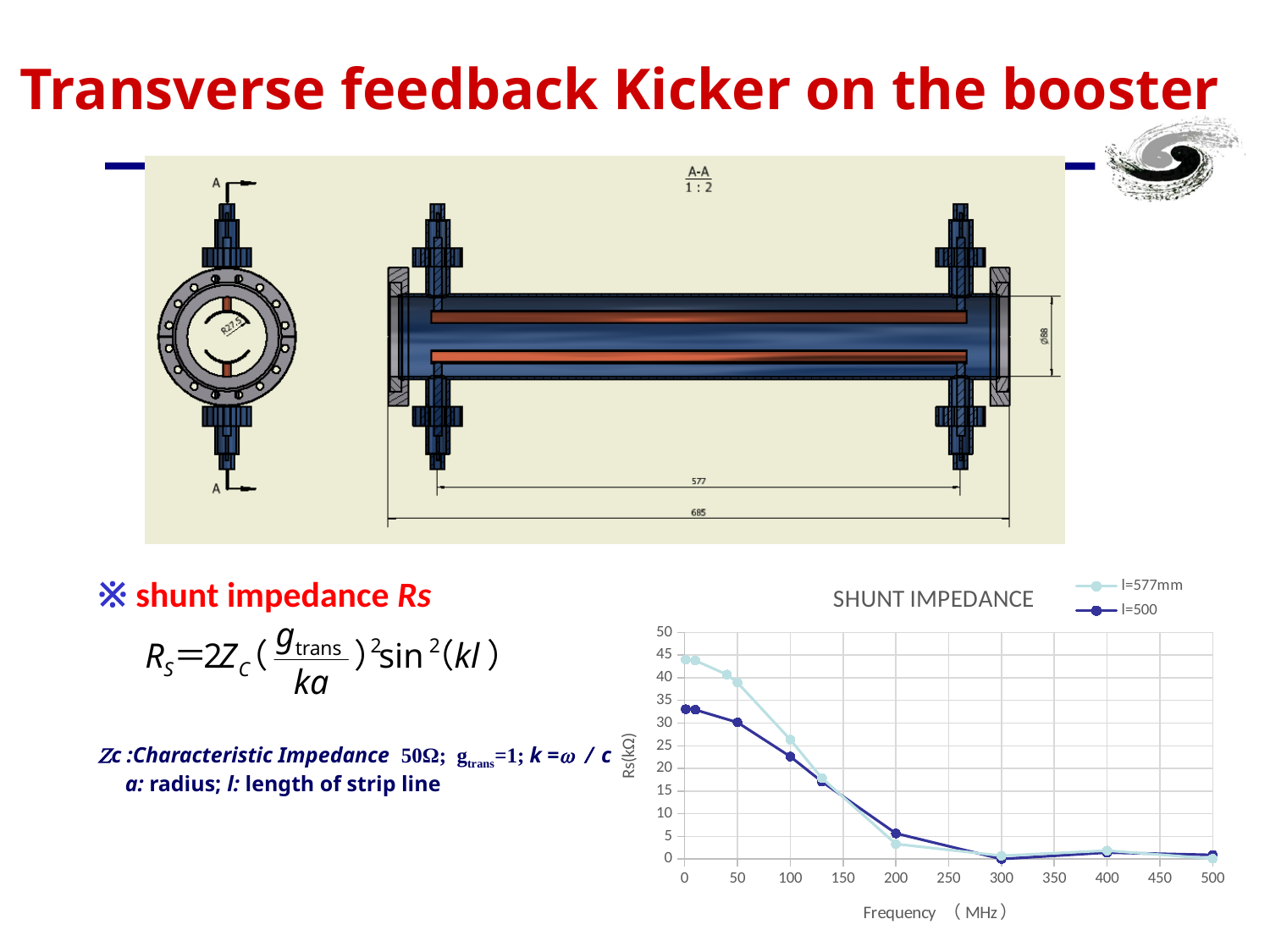
In the SHUNT IMPEDANCE chart, is the value for l=500 at 100 MHz greater or less than 25? less In the SHUNT IMPEDANCE chart, is the value for l=500 at 0 MHz greater or less than 35? less What is the label of the horizontal axis of the SHUNT IMPEDANCE chart? Frequency (MHz) In the SHUNT IMPEDANCE chart, is the value for l=577mm at 200 MHz greater or less than 5? less What kind of chart is the SHUNT IMPEDANCE chart? line chart What is the label of the vertical axis of the SHUNT IMPEDANCE chart? Rs(kΩ) How many series does the legend of the SHUNT IMPEDANCE chart list? 2 In the SHUNT IMPEDANCE chart, which series has the higher value at 0 MHz, l=577mm or l=500? l=577mm In the SHUNT IMPEDANCE chart, do the values rise or fall as frequency increases from 0 to 300 MHz? fall In the SHUNT IMPEDANCE chart, which series has the higher value at 200 MHz, l=577mm or l=500? l=500